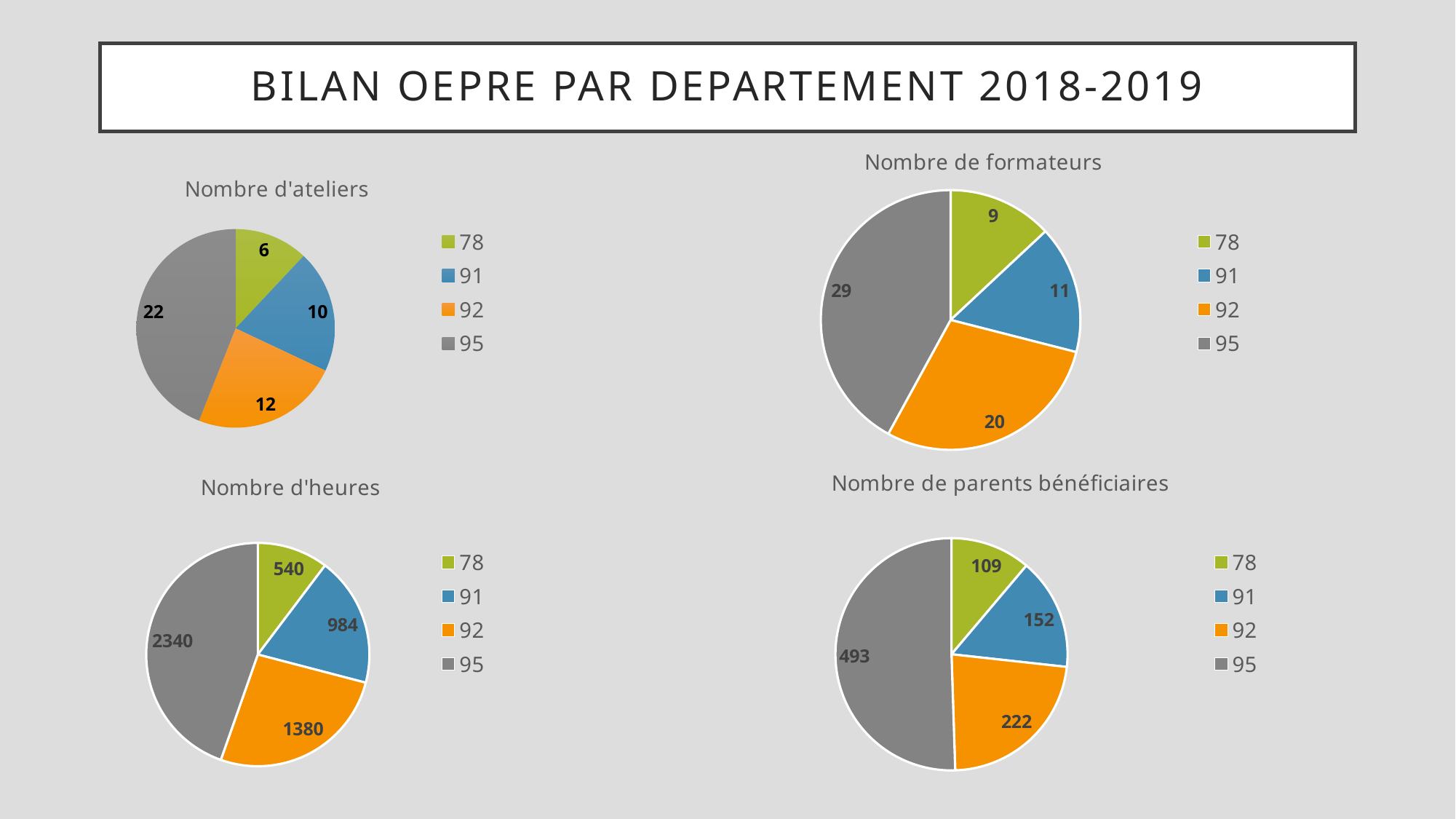
In the 'Nombre d'ateliers' chart, which department has the largest slice? 95 In the 'Nombre d'heures' chart, what is the difference between the values for departments 92 and 91? 396 In the 'Nombre d'ateliers' chart, what is the value for department 92? 12 In the 'Nombre de formateurs' chart, which department has the smallest slice? 78 In the 'Nombre de parents bénéficiaires' chart, what is the value for department 78? 109 In the 'Nombre de formateurs' chart, what is the value for department 91? 11 How many slices does the 'Nombre d'heures' chart have? 4 How many entries does the legend of the 'Nombre de parents bénéficiaires' chart list? 4 In the 'Nombre d'heures' chart, what is the value for department 95? 2340 In the 'Nombre d'ateliers' chart, what share of the total does department 95 represent? 44% In the 'Nombre de parents bénéficiaires' chart, which is larger, the value for department 92 or department 91? 92 What kind of chart is 'Nombre de formateurs'? Pie chart